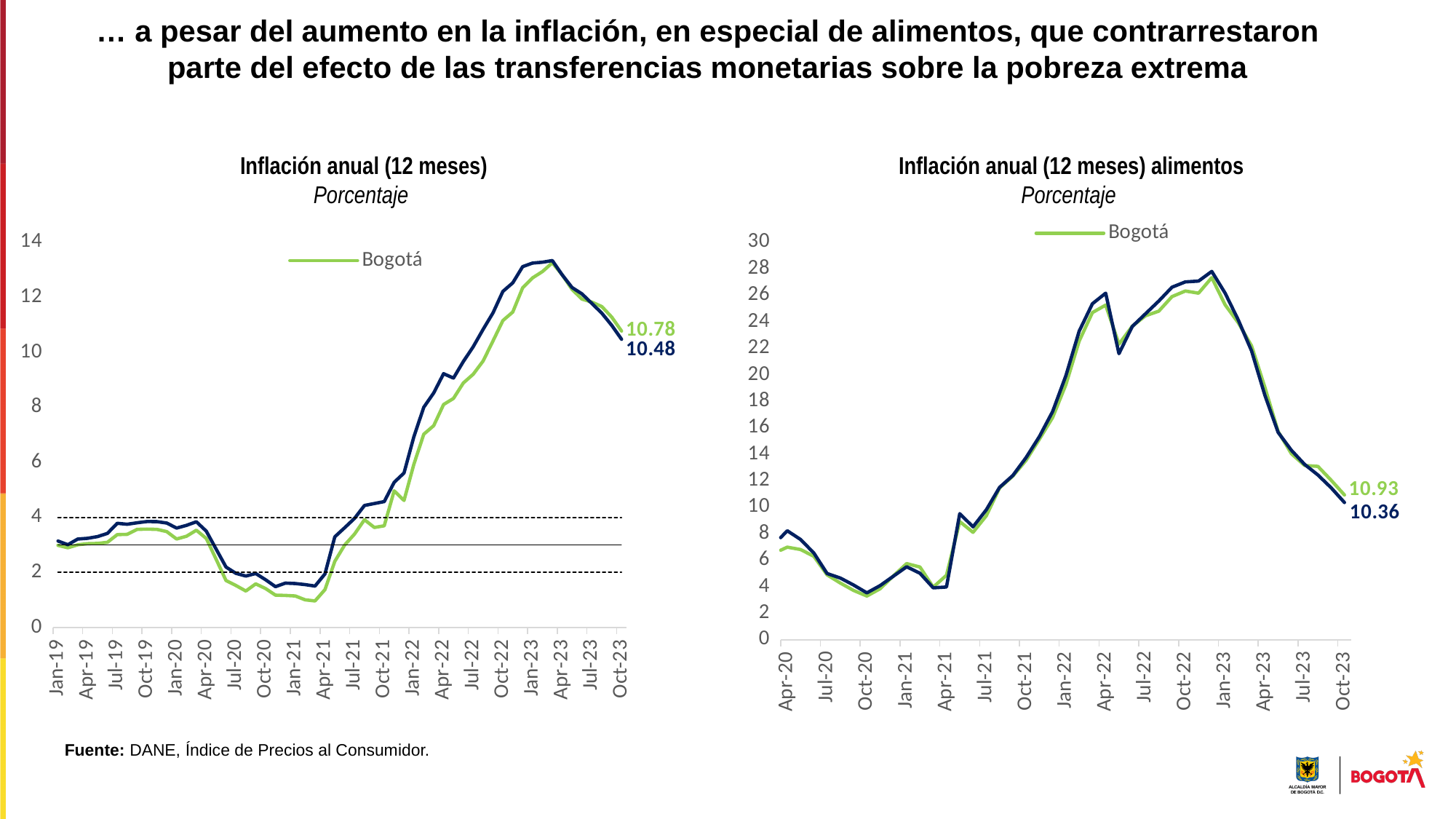
How many entries does the legend of the right chart, 'Inflación anual (12 meses) alimentos', list? 1 What kind of chart is the left chart, 'Inflación anual (12 meses)'? Line chart In the chart titled 'Inflación anual (12 meses) alimentos', which labelled Oct-23 value is larger, Bogotá's or the dark blue line's? Bogotá's (10.93) In the chart titled 'Inflación anual (12 meses)', what is the labelled value of the dark blue line at Oct-23? 10.48 In the chart titled 'Inflación anual (12 meses)', what is the labelled value for Bogotá at Oct-23? 10.78 In the chart titled 'Inflación anual (12 meses) alimentos', is the Bogotá value at Oct-20 greater or less than 4? less In the chart titled 'Inflación anual (12 meses)', what is the difference between the two labelled Oct-23 values, 10.78 and 10.48? 0.30 What colour is the Bogotá line in the left chart, 'Inflación anual (12 meses)'? Green In the chart titled 'Inflación anual (12 meses) alimentos', do the values rise or fall between Jan-23 and Oct-23? Fall In the chart titled 'Inflación anual (12 meses)', is the Bogotá value at Jan-21 greater or less than 2? less In the chart titled 'Inflación anual (12 meses) alimentos', what is the labelled value for Bogotá at Oct-23? 10.93